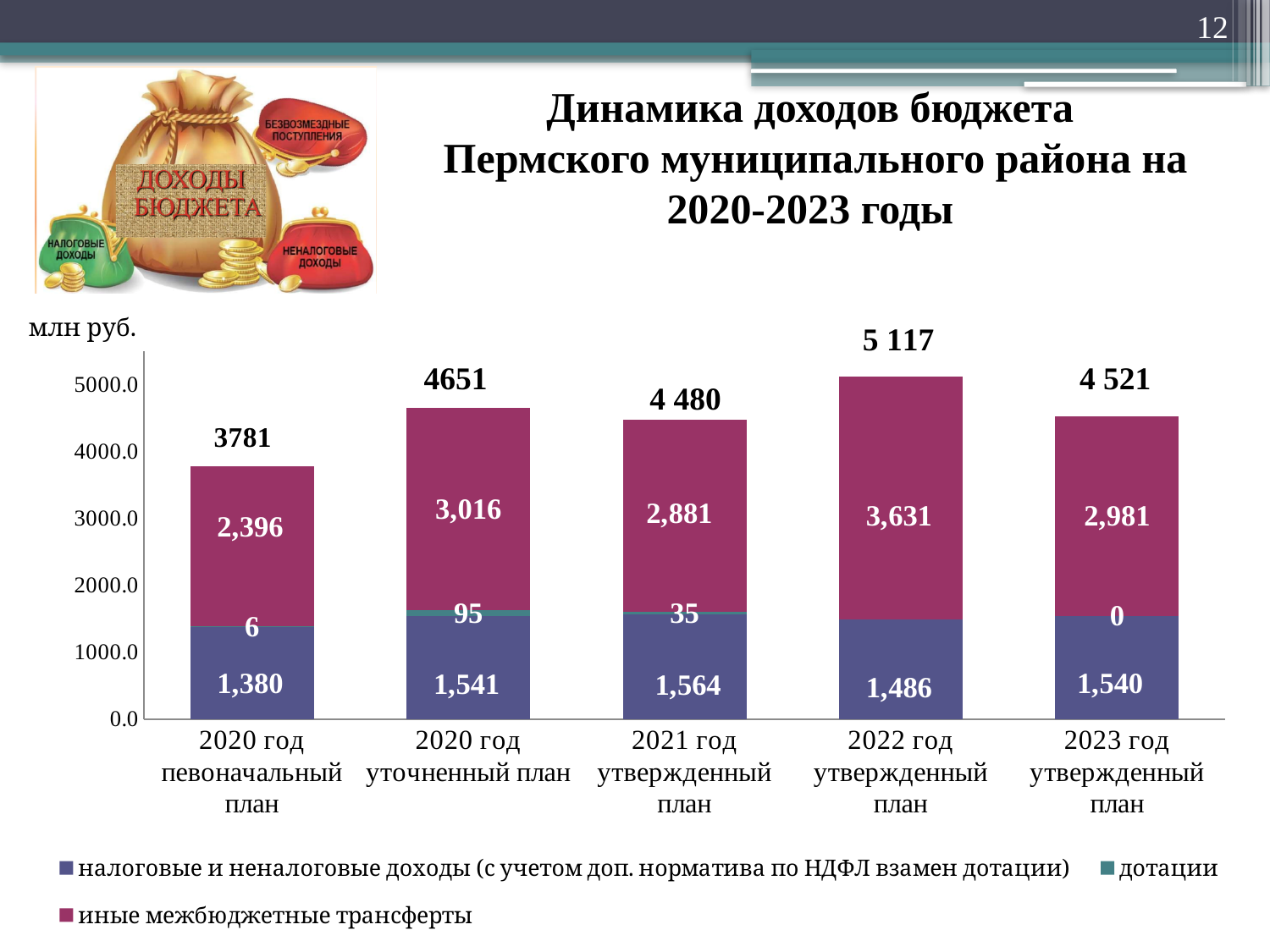
Which category has the lowest total? 2020 год певоначальный план Which category has the highest total? 2022 год утвержденный план What is the value of налоговые и неналоговые доходы for 2021 год утвержденный план? 1,564 What is the value of иные межбюджетные трансферты for 2020 год уточненный план? 3,016 What is the difference between the totals for 2022 год утвержденный план and 2023 год утвержденный план? 596 What type of chart is shown on the slide? stacked bar chart What unit is indicated above the vertical axis of the chart? млн руб. Which is larger: иные межбюджетные трансферты for 2021 год утвержденный план or for 2023 год утвержденный план? 2023 год утвержденный план What is the value of дотации for 2020 год уточненный план? 95 How many series does the legend list? 3 What is the total value printed above the bar for 2022 год утвержденный план? 5 117 How many bars (categories) are shown in the chart? 5